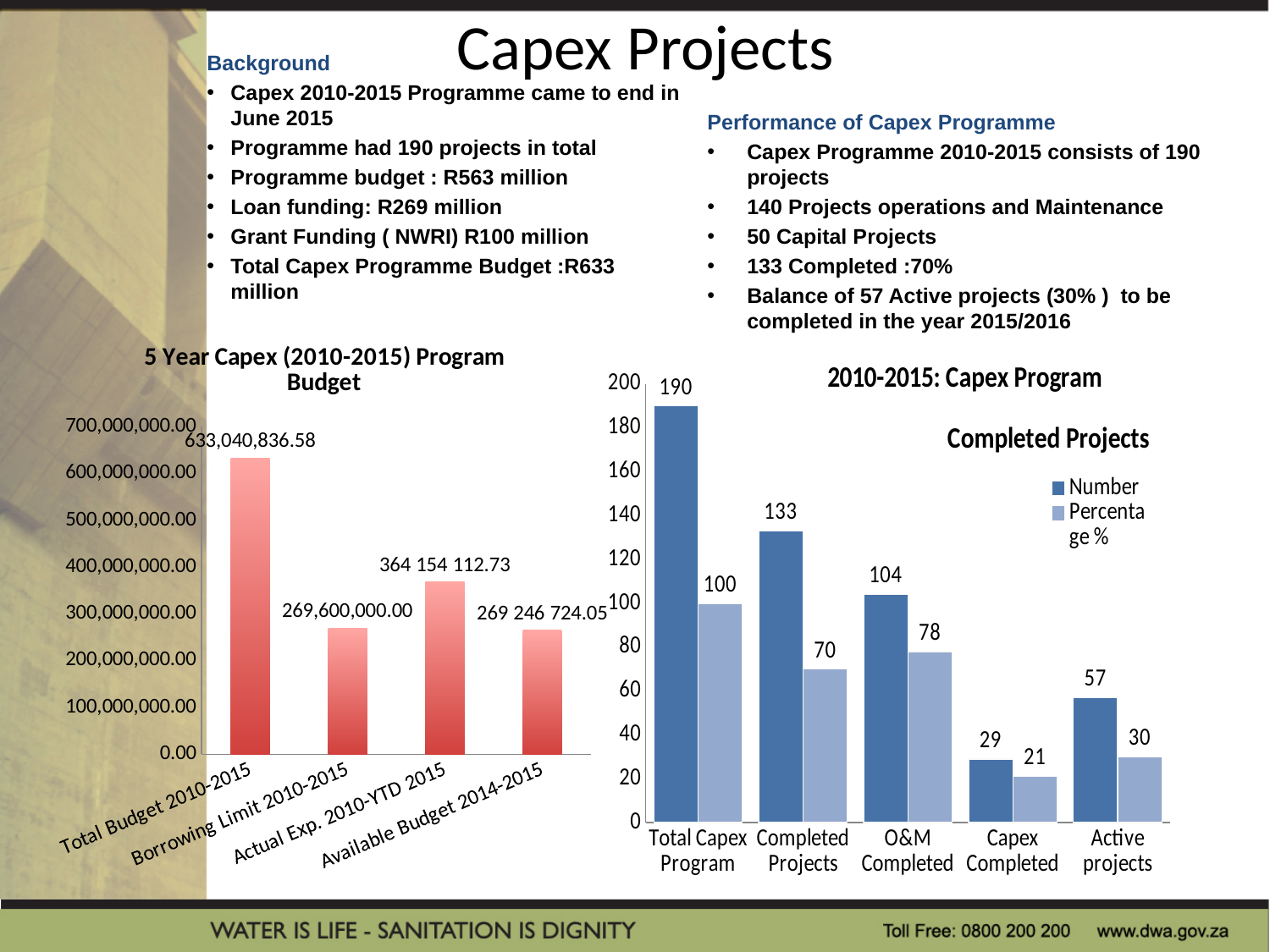
In the '2010-2015: Capex Program Completed Projects' chart, is the Number value for Active projects larger than the Number value for Capex Completed? Yes In the '2010-2015: Capex Program Completed Projects' chart, what is the difference between the Number values for Total Capex Program and Completed Projects? 57 In the '5 Year Capex (2010-2015) Program Budget' chart, what is the value for Total Budget 2010-2015? 633,040,836.58 In the '5 Year Capex (2010-2015) Program Budget' chart, is the value for Borrowing Limit 2010-2015 greater or less than 300,000,000.00? less In the '2010-2015: Capex Program Completed Projects' chart, what is the Number value for Completed Projects? 133 In the '2010-2015: Capex Program Completed Projects' chart, what is the Percentage % value for O&M Completed? 78 In the '5 Year Capex (2010-2015) Program Budget' chart, what is the value for Actual Exp. 2010-YTD 2015? 364 154 112.73 What kind of chart is the '5 Year Capex (2010-2015) Program Budget' chart? bar chart In the '2010-2015: Capex Program Completed Projects' chart, how many series does the legend list? 2 In the '5 Year Capex (2010-2015) Program Budget' chart, which category has the highest value? Total Budget 2010-2015 In the '5 Year Capex (2010-2015) Program Budget' chart, how many categories are shown? 4 In the '2010-2015: Capex Program Completed Projects' chart, which category has the lowest Number value? Capex Completed